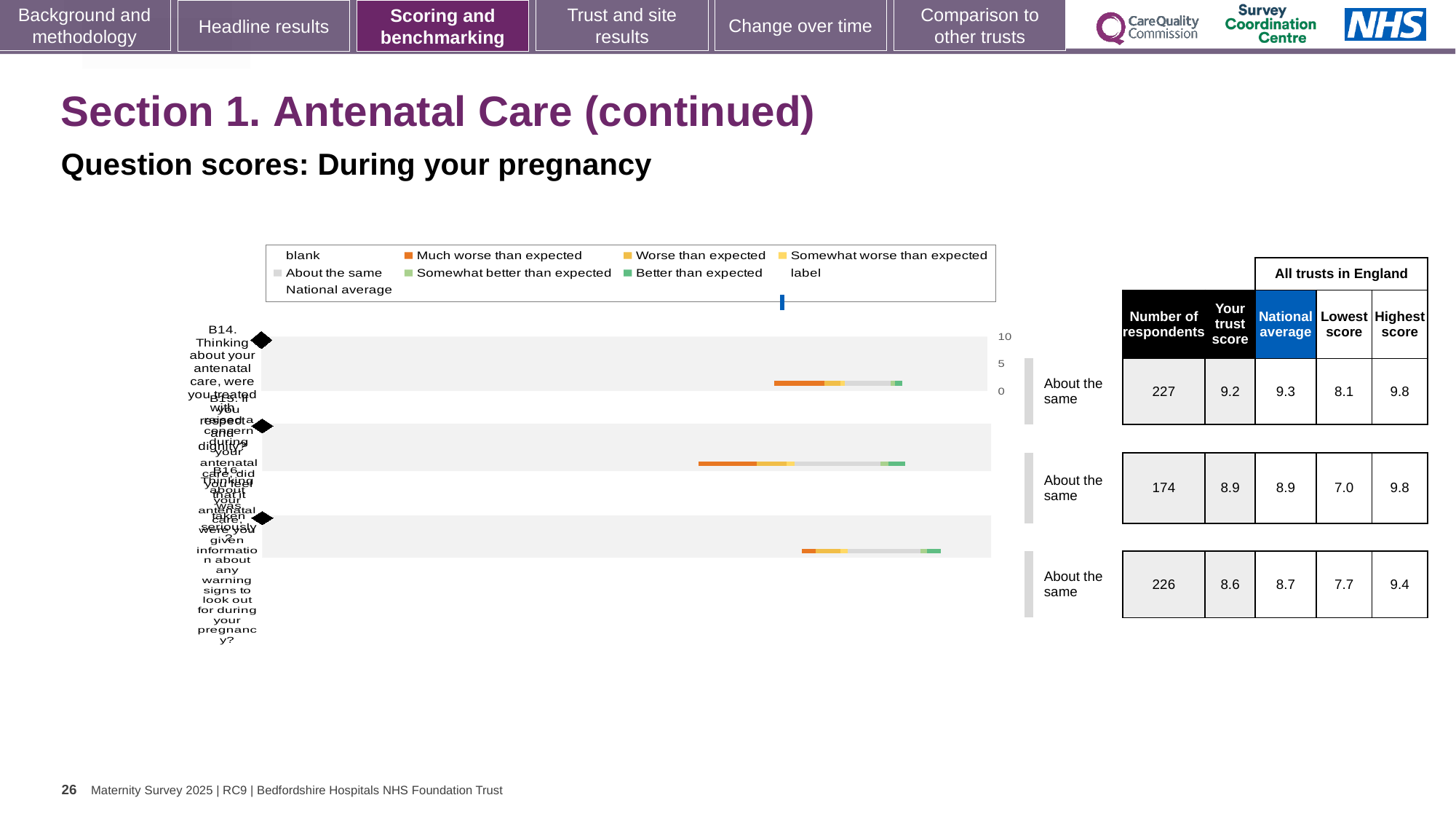
For the first question row, B14, which is larger: the trust score or the national average? National average In the chart legend, what does the dark orange segment represent? Much worse than expected What is the highest score among all trusts in England for the first question row, B14? 9.8 For the third (bottom) question row, what is the difference between the highest score and the lowest score? 1.7 What is the trust score for the second question row? 8.9 What is the lowest score among all trusts in England for the second question row? 7.0 What is the number of respondents for the first (top) question row, B14? 227 What is the national average for the third (bottom) question row? 8.7 Which question row has the highest number of respondents? The first row, B14 (227) What kind of chart is shown on the slide? bar chart How many question rows are plotted in the chart? 3 What benchmark category is shown for all three question rows? About the same